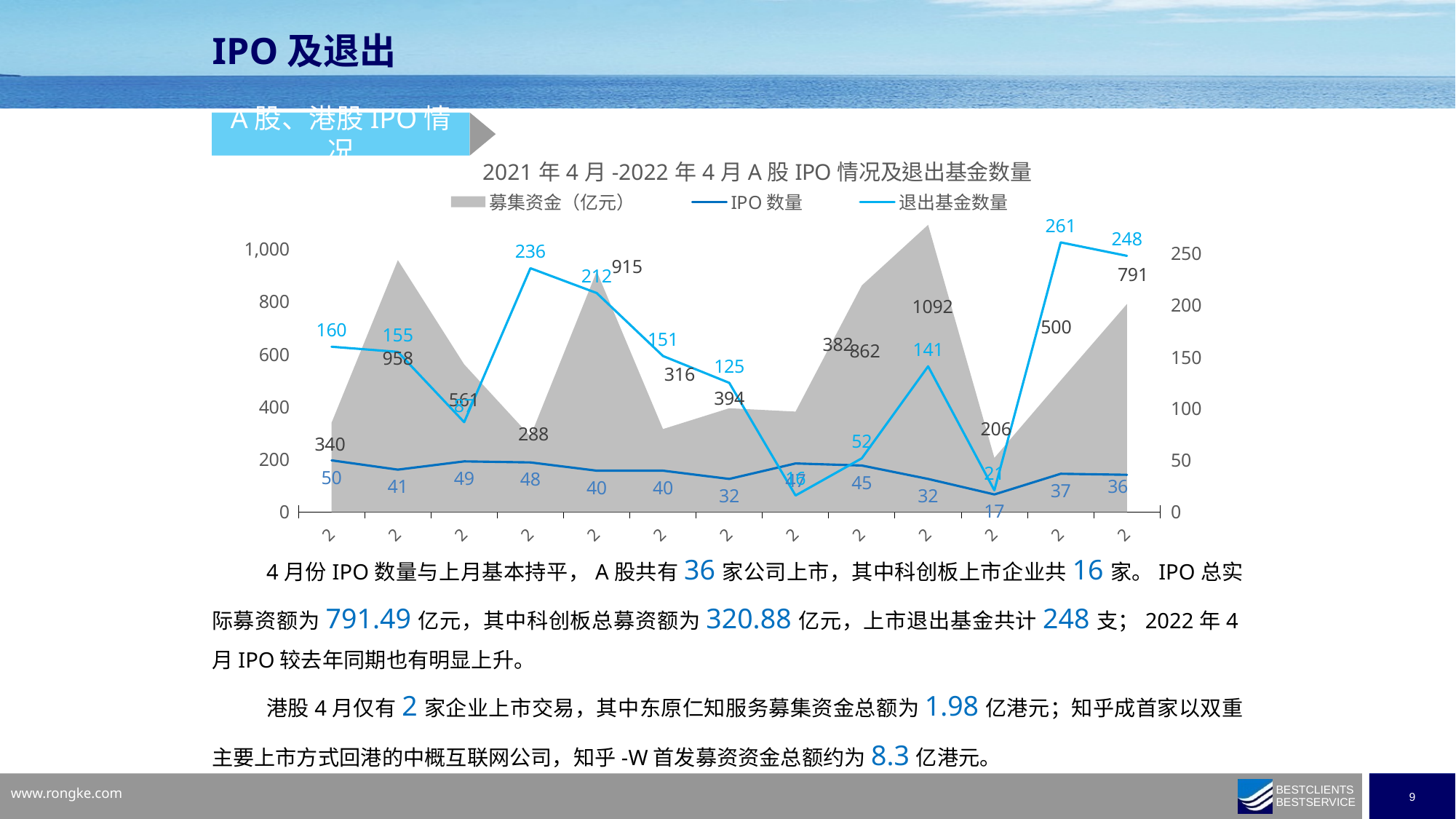
What kind of chart is shown on the slide? A combined area and line chart What is the lowest value of 募集资金（亿元） shown in the chart? 206 What is the lowest value of IPO 数量 shown in the chart? 17 What is the highest value of 退出基金数量 shown in the chart? 261 Which is larger: the 募集资金 value of 1092 or the 募集资金 value of 958? 1092 What is the highest value of 募集资金（亿元） shown in the chart? 1092 Which series is represented by the gray shaded area in the chart? 募集资金（亿元） What is the 募集资金（亿元） value at the last data point of the chart? 791 How many series does the chart legend list? 3 How many data points does each series in the chart have? 13 What is the highest value of IPO 数量 shown in the chart? 50 What is the difference between the two highest 退出基金数量 values, 261 and 248? 13